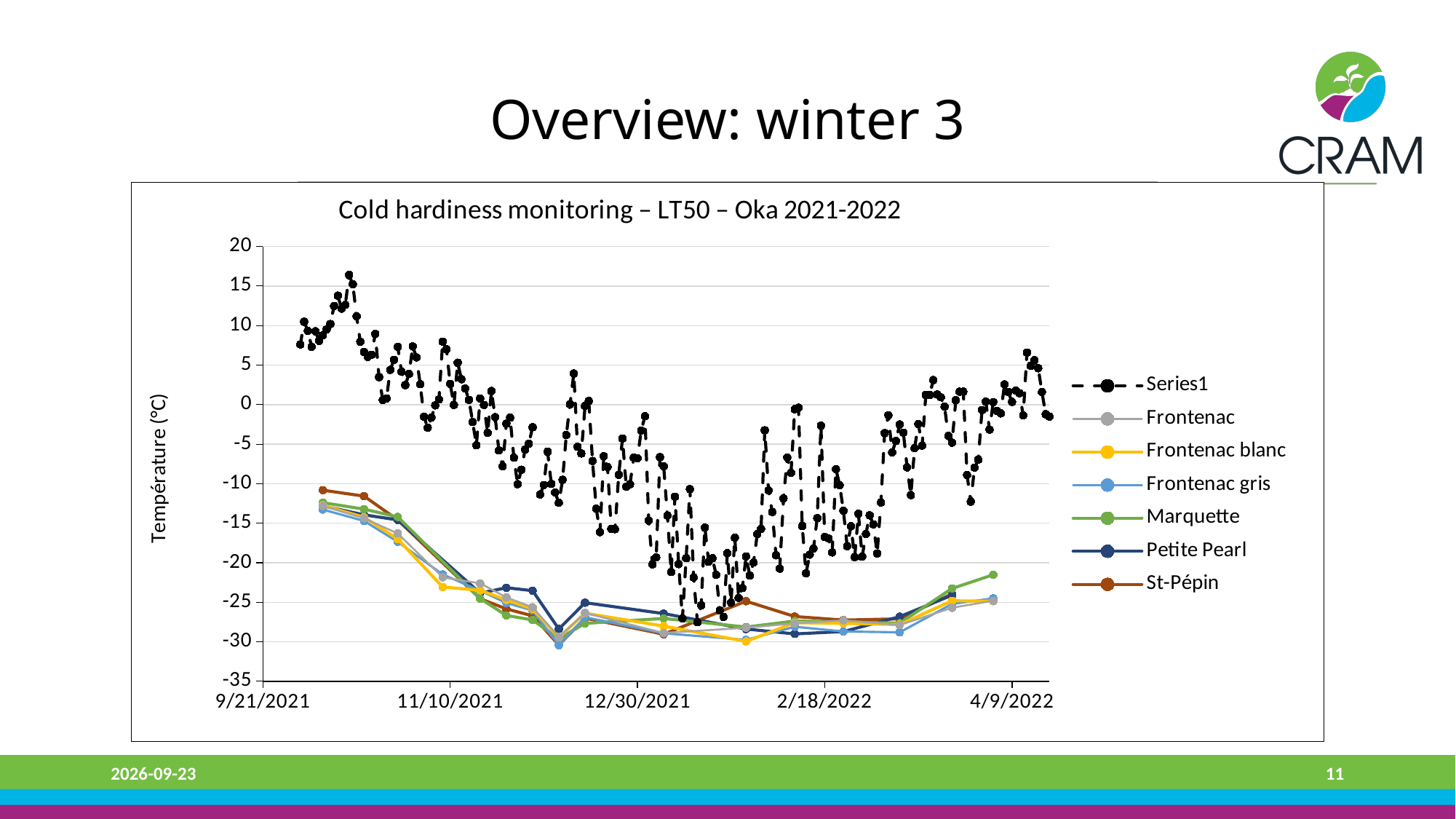
Is the lowest value of Frontenac blanc (around late January 2022) greater or less than -25? less Is the highest value of Series1 (in early October 2021) greater or less than 10? greater Is the last plotted value of Marquette (April 2022) greater or less than -25? greater What kind of chart is shown on the slide? Line chart At the first plotted date, is the value for St-Pépin higher or lower than the value for Frontenac gris? Higher Which cultivar series has the highest value at the last plotted date in April 2022? Marquette Which cultivar series has the highest value at the first plotted date in late September 2021? St-Pépin What is the label on the vertical axis of the chart? Température (°C) How many series does the legend list? 7 How do the cultivar LT50 values change from September 2021 to late December 2021? They fall What is the title of the chart? Cold hardiness monitoring – LT50 – Oka 2021-2022